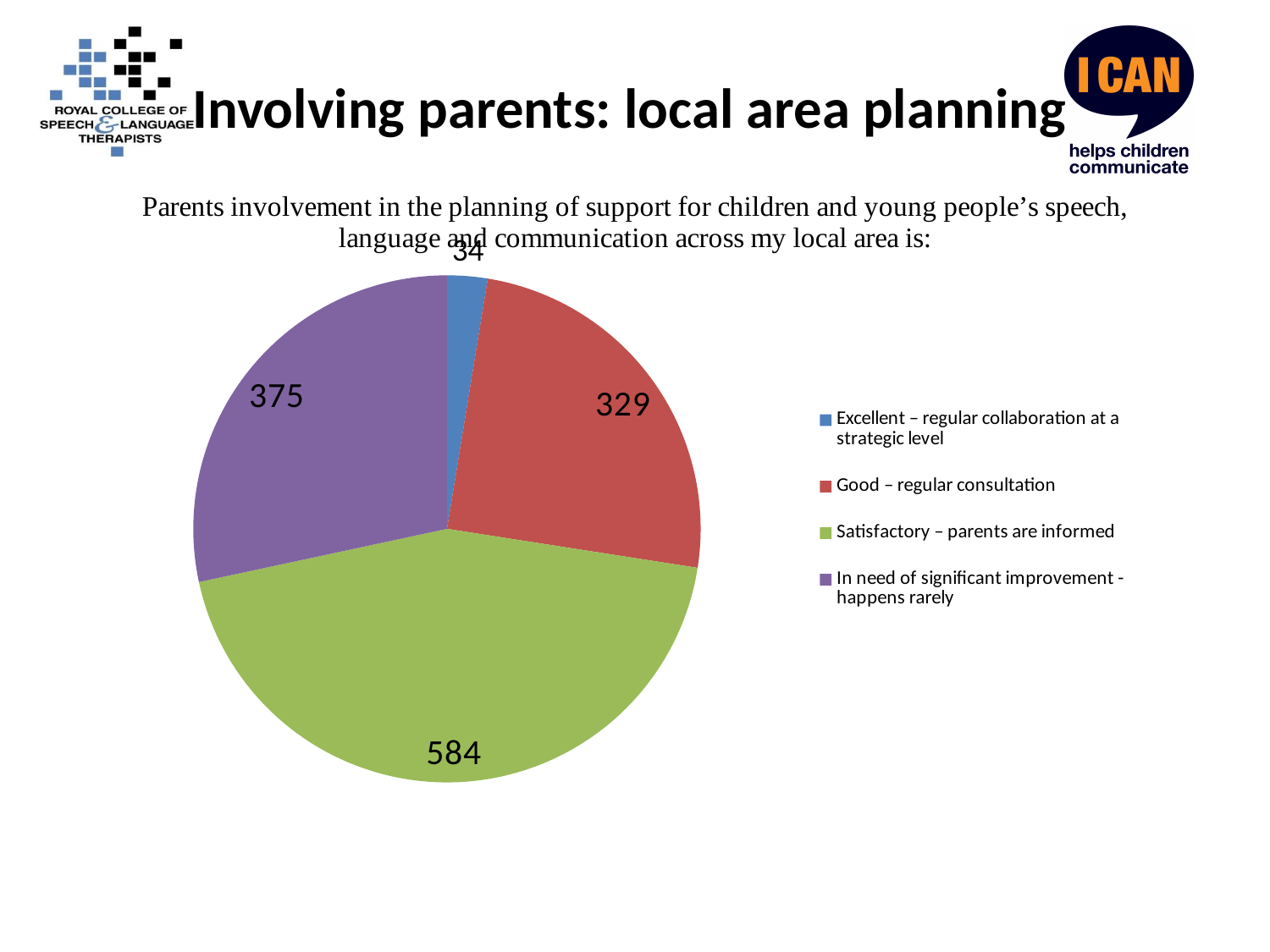
What value is shown for the 'Satisfactory – parents are informed' slice? 584 What value is shown for the 'Excellent – regular collaboration at a strategic level' slice? 34 What type of chart is shown on the slide? Pie chart What is the difference between the 'Satisfactory – parents are informed' value and the 'Good – regular consultation' value? 255 What value is shown for the 'In need of significant improvement - happens rarely' slice? 375 What value is shown for the 'Good – regular consultation' slice? 329 Which category has the largest slice of the pie? Satisfactory – parents are informed Which is larger: the 'In need of significant improvement - happens rarely' slice or the 'Good – regular consultation' slice? In need of significant improvement - happens rarely Which category has the smallest slice of the pie? Excellent – regular collaboration at a strategic level What is the total of all the values shown on the pie chart? 1322 How many slices does the pie chart have? 4 What colour is the 'Satisfactory – parents are informed' slice? Green